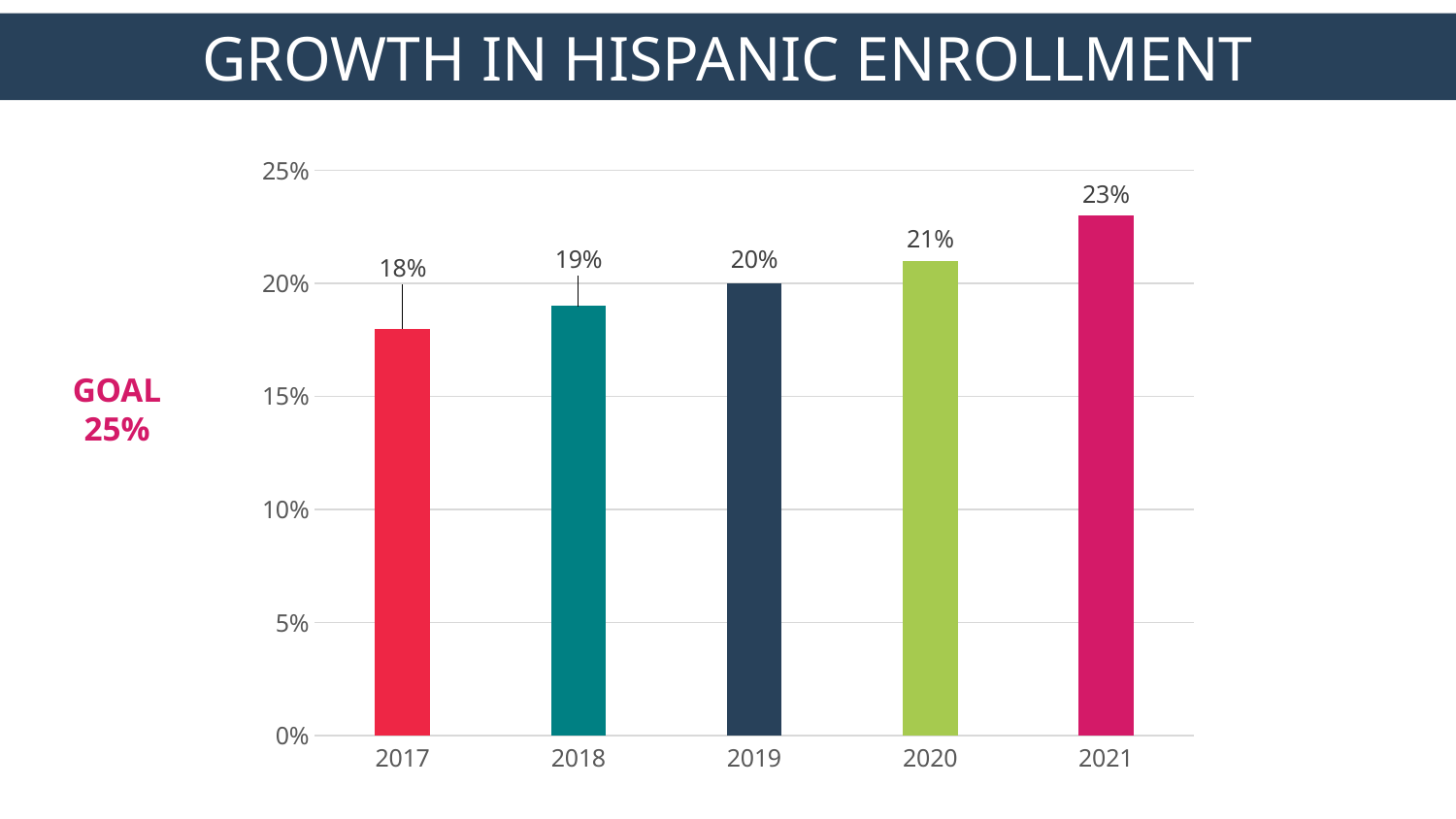
What is the Hispanic enrollment value for 2021? 23% Is the value for 2021 greater or less than 20%? greater How many years are shown on the chart? 5 What is the Hispanic enrollment value for 2019? 20% What is the difference between the 2020 and 2018 values? 2% Which year has the highest Hispanic enrollment? 2021 Do the values rise or fall from 2017 to 2021? rise Which is larger, the value for 2018 or the value for 2020? 2020 Which year has the lowest Hispanic enrollment? 2017 What is the Hispanic enrollment value for 2017? 18% What is the difference between the 2021 and 2017 values? 5% What kind of chart is shown on the slide? bar chart